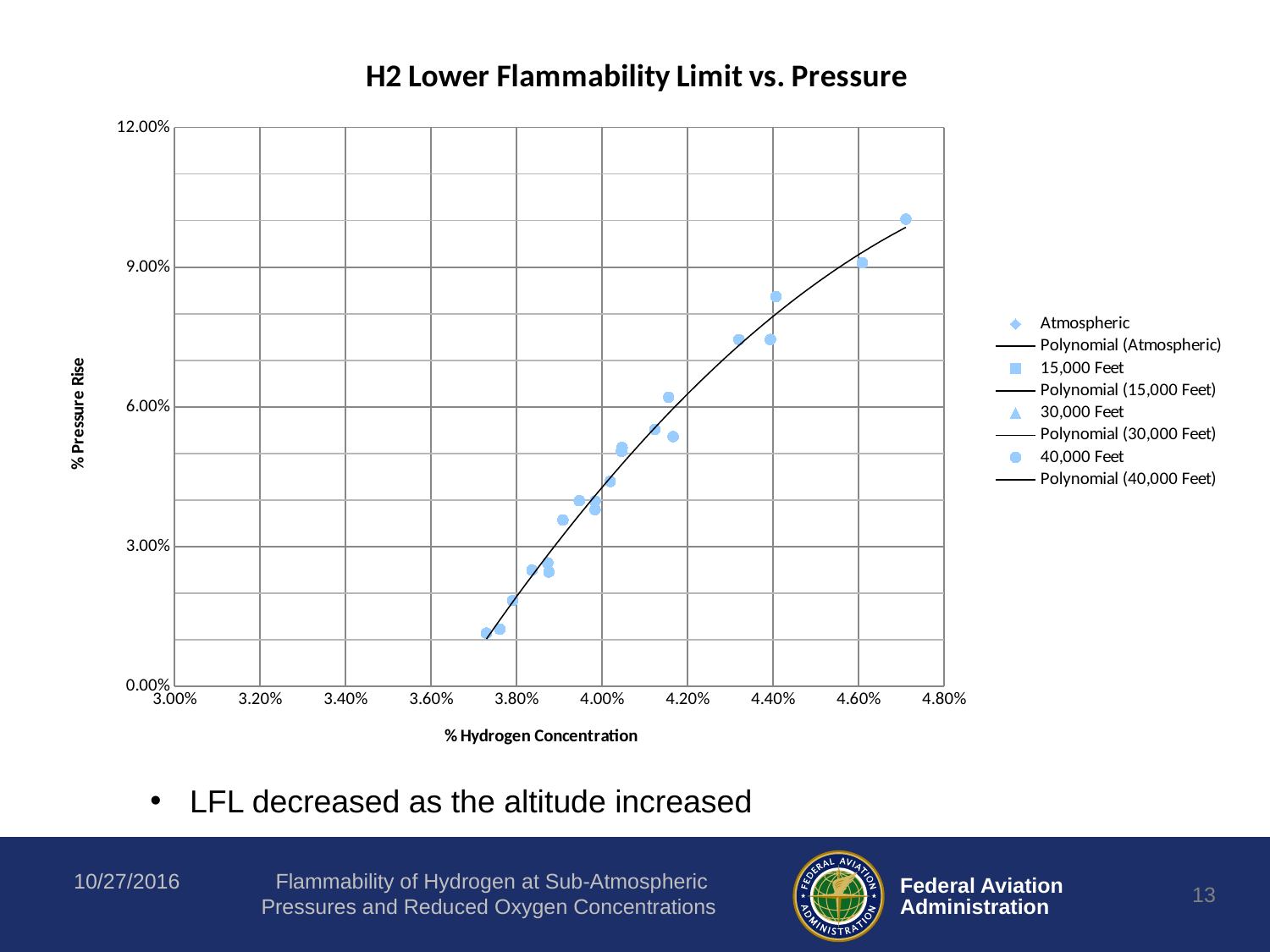
Is the highest plotted pressure rise greater or less than 9.00%? greater How many altitude data series (excluding the polynomial trendlines) does the legend list? 4 Is the smallest hydrogen concentration plotted greater or less than 3.80%? less What kind of chart is shown on the slide? Scatter chart Is the largest hydrogen concentration plotted greater or less than 4.60%? greater What is the title of the chart? H2 Lower Flammability Limit vs. Pressure Does the pressure rise increase or decrease as hydrogen concentration increases along the x axis? Increase Which is larger: the pressure rise at the rightmost plotted point or at the leftmost plotted point? The rightmost point What is the label of the vertical axis of the chart? % Pressure Rise How many entries does the chart's legend list? 8